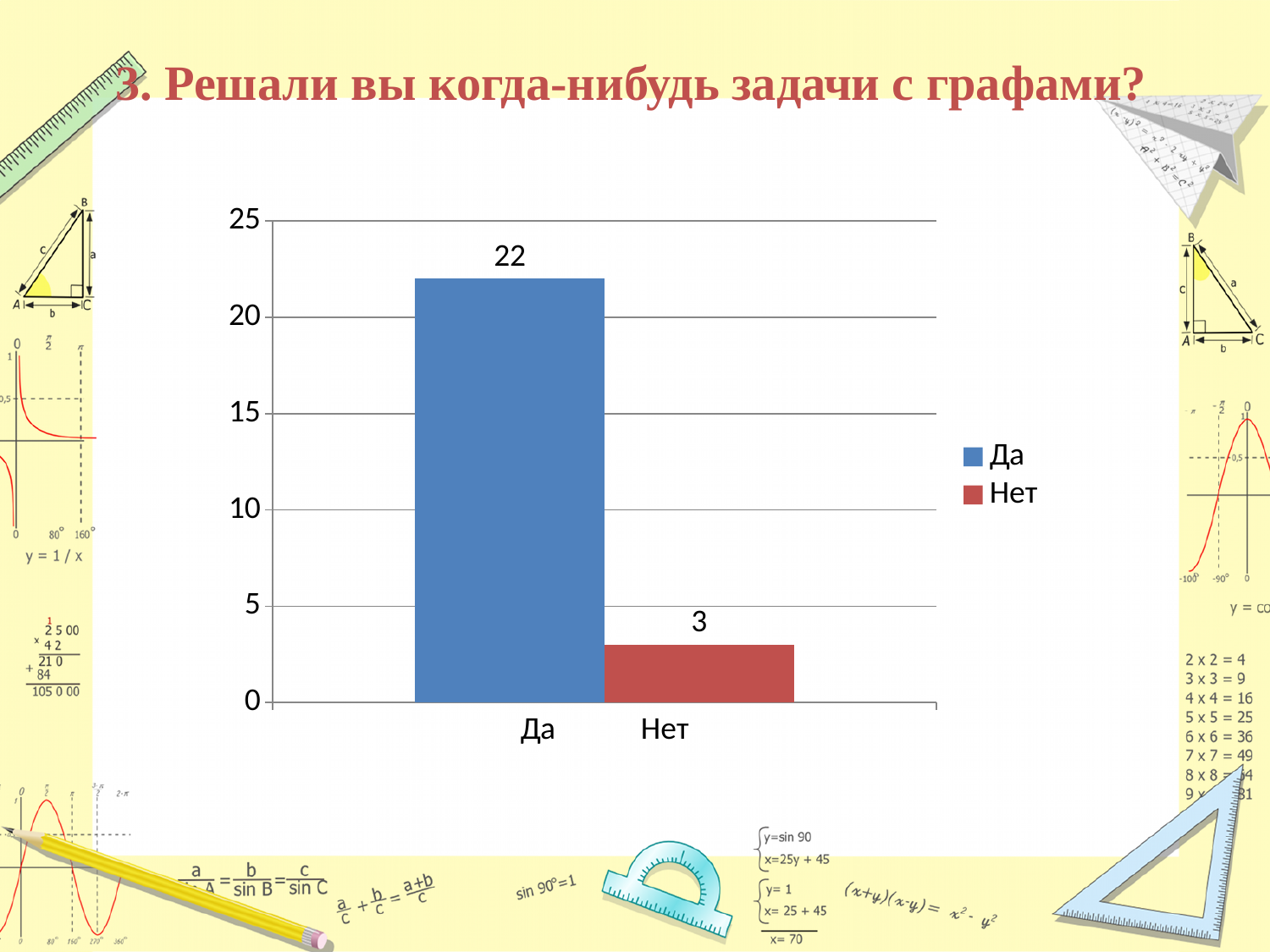
What is the value for "Нет"? 3 What is the difference between the values for "Да" and "Нет"? 19 What is the value for "Да"? 22 Which category has the lowest value? Нет How many categories are shown on the x axis? 2 What kind of chart is shown on the slide? bar chart Is the value for "Нет" greater or less than 5? less Is the value for "Да" greater or less than 20? greater Which is larger, the value for "Да" or the value for "Нет"? Да Which category has the highest value? Да What colour is the bar for "Нет"? red How many entries does the legend list? 2